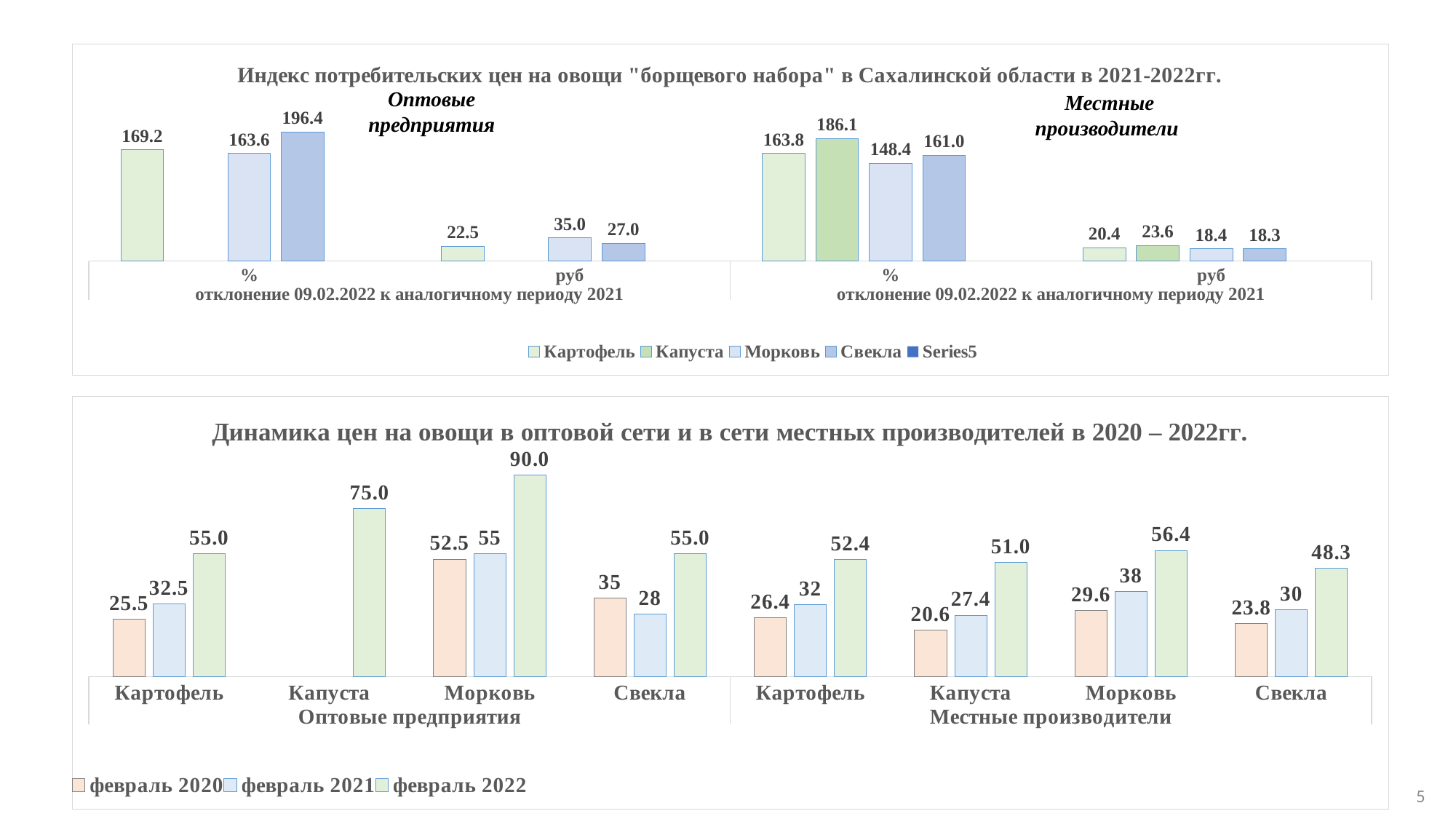
In the top chart (Индекс потребительских цен...), which vegetable has the lowest руб value for Местные производители? Свекла In the bottom chart (Динамика цен на овощи...), what is the difference between the февраль 2022 and февраль 2020 values for Картофель in Оптовые предприятия? 29.5 In the top chart (Индекс потребительских цен...), what is the руб value for Капуста for Местные производители? 23.6 In the bottom chart (Динамика цен на овощи...), what is the value for Капуста in февраль 2021 for Местные производители? 27.4 In the bottom chart (Динамика цен на овощи...), for Свекла in Оптовые предприятия, which is larger: the февраль 2020 value or the февраль 2021 value? февраль 2020 How many entries does the legend of the top chart (Индекс потребительских цен...) list? 5 How many series does the legend of the bottom chart (Динамика цен на овощи...) list? 3 In the bottom chart (Динамика цен на овощи...), which vegetable has the highest февраль 2022 value among Оптовые предприятия? Морковь In the top chart (Индекс потребительских цен...), which is larger: the % value for Картофель in Оптовые предприятия or the % value for Картофель in Местные производители? Оптовые предприятия In the bottom chart (Динамика цен на овощи...), what is the value for Морковь in февраль 2022 for Оптовые предприятия? 90.0 In the top chart (Индекс потребительских цен...), what is the % value for Свекла for Оптовые предприятия? 196.4 What kind of chart is the bottom chart (Динамика цен на овощи...)? Bar chart